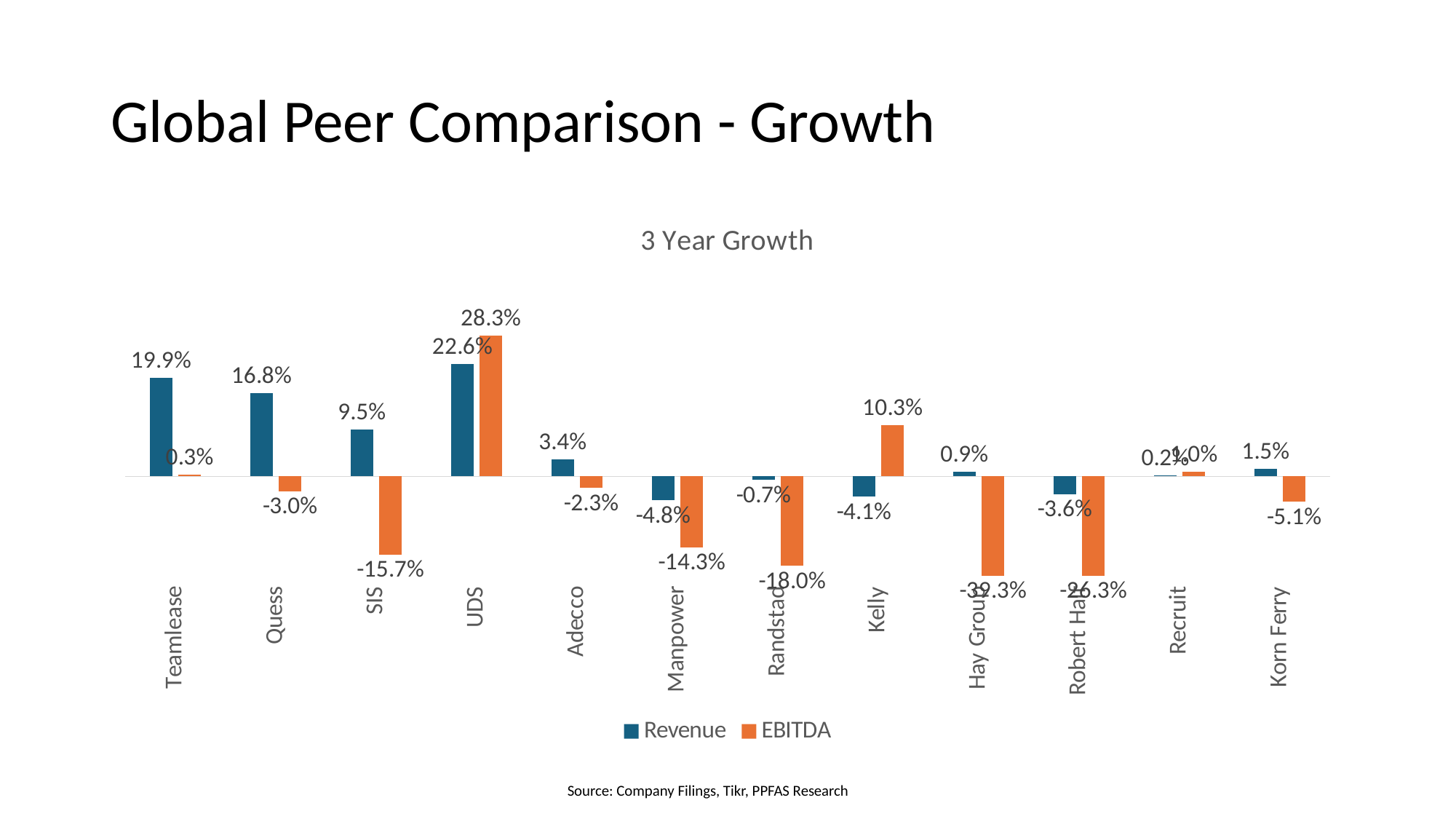
Which company has the highest EBITDA growth? UDS How many series does the legend list? 2 What is the Revenue growth value for Randstad? -0.7% What type of chart is shown on the slide? Bar chart What is the EBITDA growth value for SIS? -15.7% What is the Revenue growth value for Teamlease? 19.9% For UDS, how much higher is EBITDA growth than Revenue growth? 5.7 percentage points Which is larger: the EBITDA growth of Kelly or the Revenue growth of SIS? EBITDA growth of Kelly What is the EBITDA growth value for Kelly? 10.3% How many companies are shown on the x axis? 12 What is the difference between the Revenue growth of Teamlease and Quess? 3.1 percentage points Which company has the highest Revenue growth? UDS